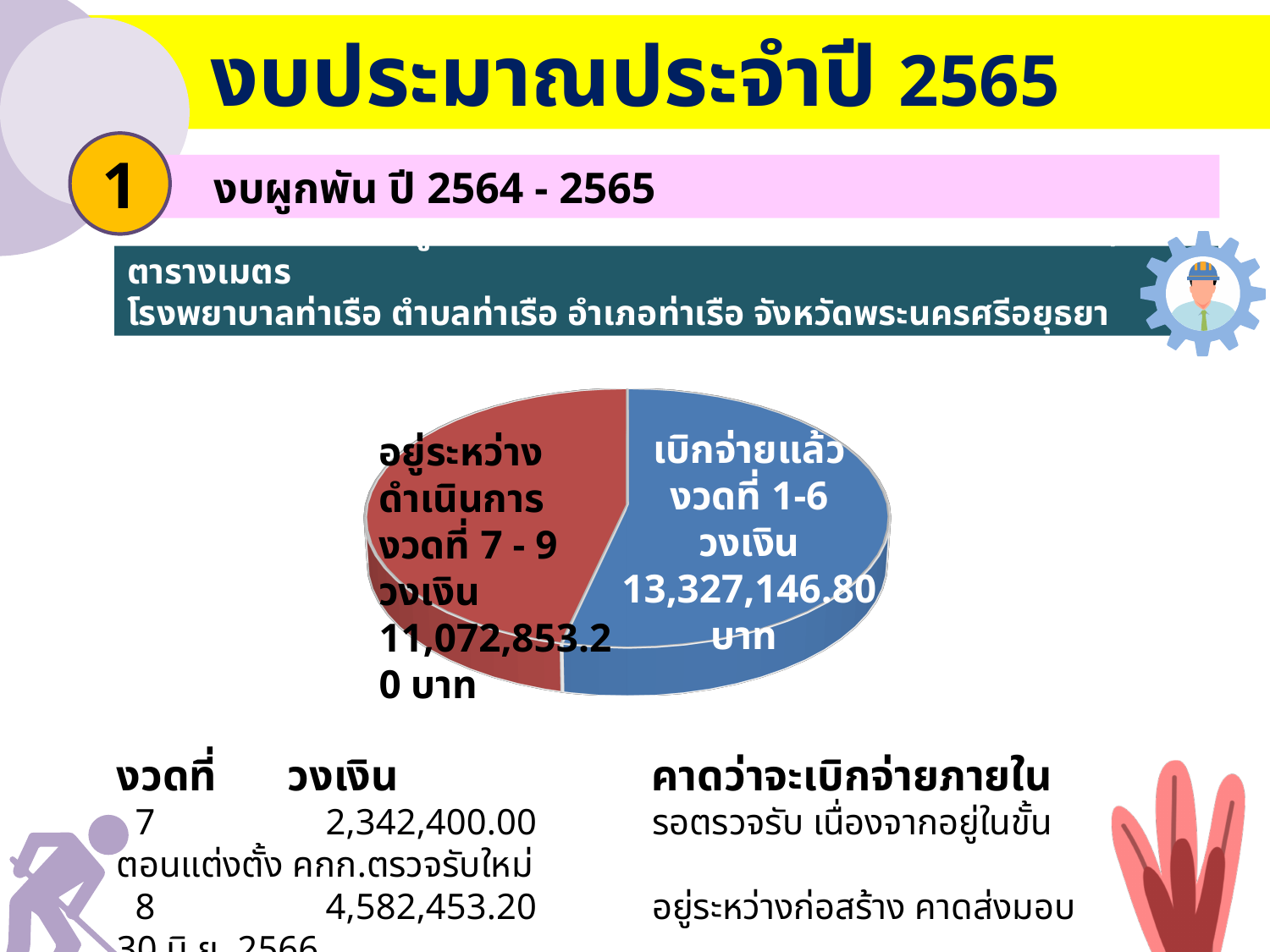
Which slice of the pie chart has the larger amount? เบิกจ่ายแล้ว งวดที่ 1-6 Which slice of the pie chart has the smaller amount? อยู่ระหว่างดำเนินการ งวดที่ 7 - 9 How many slices does the pie chart have? 2 What kind of chart is shown on the slide? pie chart What is the total of the two amounts shown in the pie chart? 24,400,000.00 บาท What colour is the slice labelled อยู่ระหว่างดำเนินการ งวดที่ 7 - 9? red What is the amount for the slice labelled อยู่ระหว่างดำเนินการ งวดที่ 7 - 9? 11,072,853.20 บาท Is the amount for เบิกจ่ายแล้ว งวดที่ 1-6 larger or smaller than the amount for อยู่ระหว่างดำเนินการ งวดที่ 7 - 9? larger What is the difference between the amount for เบิกจ่ายแล้ว งวดที่ 1-6 and the amount for อยู่ระหว่างดำเนินการ งวดที่ 7 - 9? 2,254,293.60 บาท What is the amount for the slice labelled เบิกจ่ายแล้ว งวดที่ 1-6? 13,327,146.80 บาท What colour is the slice labelled เบิกจ่ายแล้ว งวดที่ 1-6? blue